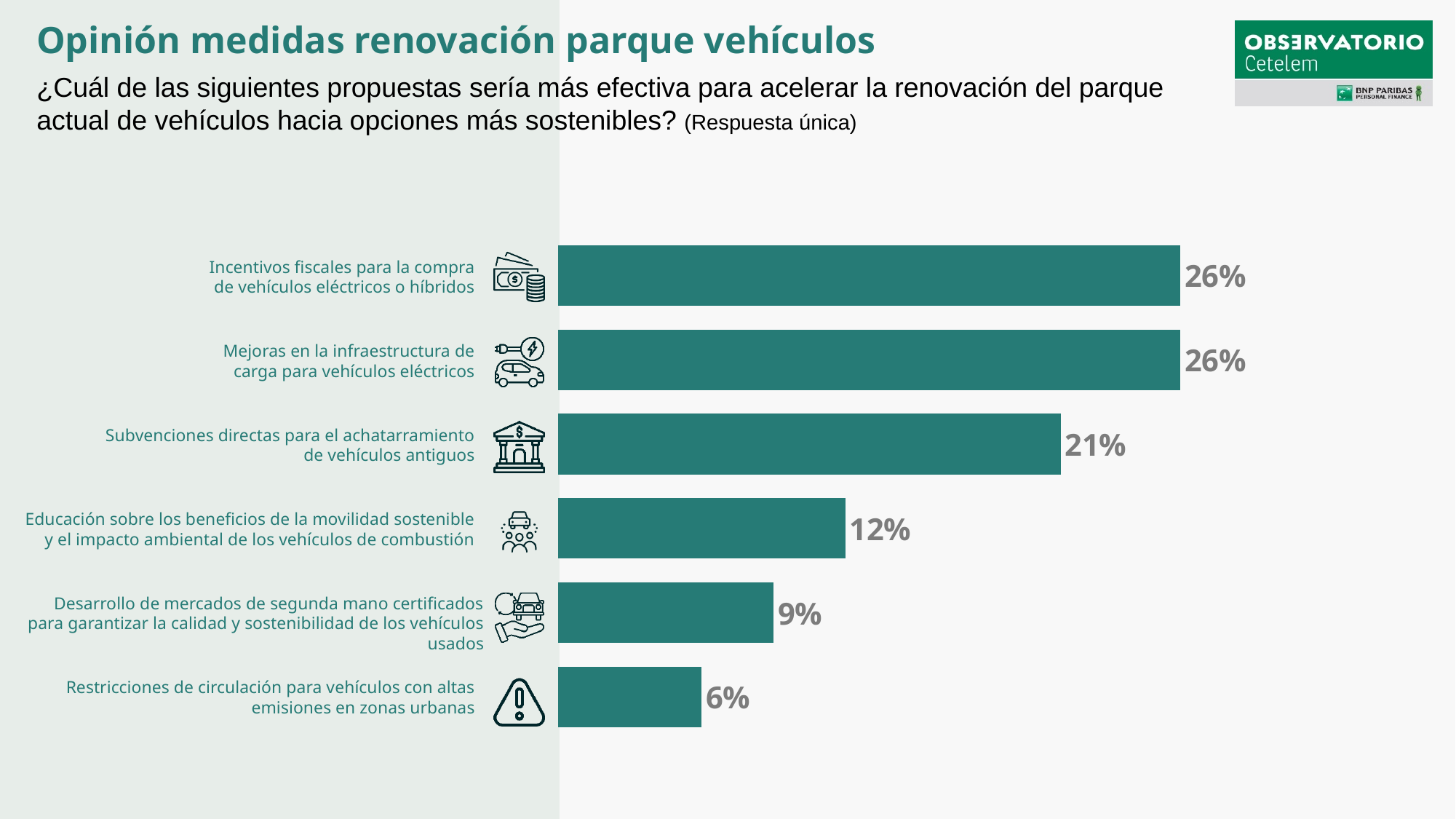
What kind of chart is shown on the slide? Bar chart What is the value for "Desarrollo de mercados de segunda mano certificados para garantizar la calidad y sostenibilidad de los vehículos usados"? 9% Which category has the lowest value? Restricciones de circulación para vehículos con altas emisiones en zonas urbanas What is the difference between the values for "Incentivos fiscales para la compra de vehículos eléctricos o híbridos" and "Restricciones de circulación para vehículos con altas emisiones en zonas urbanas"? 20% What is the title of the slide containing the chart? Opinión medidas renovación parque vehículos Which is larger: the value for "Desarrollo de mercados de segunda mano certificados para garantizar la calidad y sostenibilidad de los vehículos usados" or the value for "Restricciones de circulación para vehículos con altas emisiones en zonas urbanas"? Desarrollo de mercados de segunda mano certificados para garantizar la calidad y sostenibilidad de los vehículos usados How many categories are shown in the chart? 6 What is the value for "Mejoras en la infraestructura de carga para vehículos eléctricos"? 26% What is the value for "Subvenciones directas para el achatarramiento de vehículos antiguos"? 21% What is the value for "Restricciones de circulación para vehículos con altas emisiones en zonas urbanas"? 6% What is the value for "Educación sobre los beneficios de la movilidad sostenible y el impacto ambiental de los vehículos de combustión"? 12% What is the difference between the values for "Subvenciones directas para el achatarramiento de vehículos antiguos" and "Educación sobre los beneficios de la movilidad sostenible y el impacto ambiental de los vehículos de combustión"? 9%